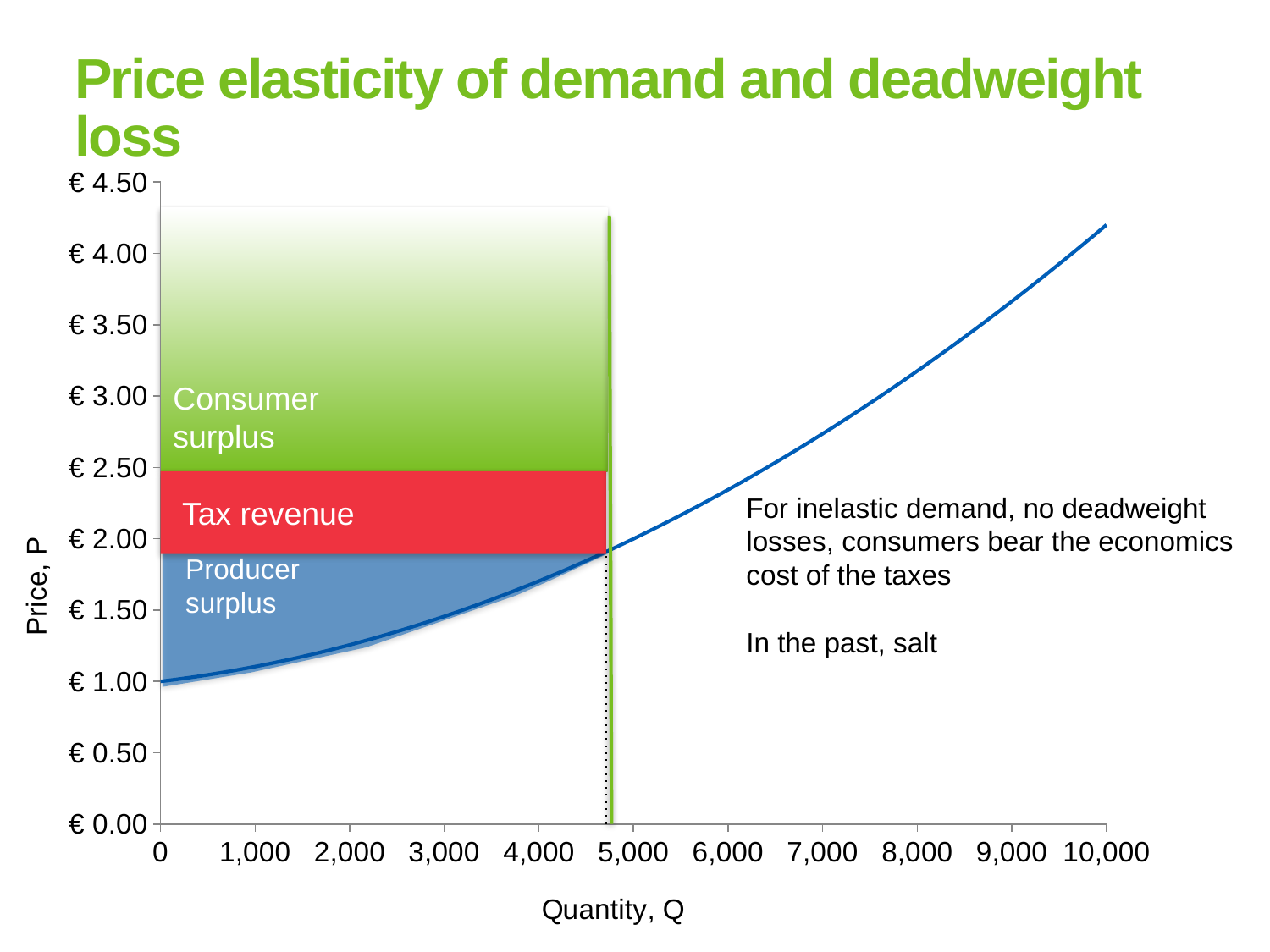
Is the price on the blue supply curve at a quantity of 10,000 greater or less than € 4.00? greater What is the title of the chart's vertical axis? Price, P What is the price on the blue supply curve at a quantity of 0? € 1.00 What kind of chart is shown on the slide? line chart Does the blue supply curve rise or fall as quantity increases along the x axis? rises Is the price on the blue supply curve at a quantity of 8,000 greater or less than € 3.00? greater Is the price on the blue supply curve at a quantity of 2,000 greater or less than € 1.50? less How many tick labels are shown on the horizontal (quantity) axis? 11 Which shaded region lies between the Consumer surplus and Producer surplus regions? Tax revenue What is the title of the chart's horizontal axis? Quantity, Q What is the highest price value labelled on the vertical axis? € 4.50